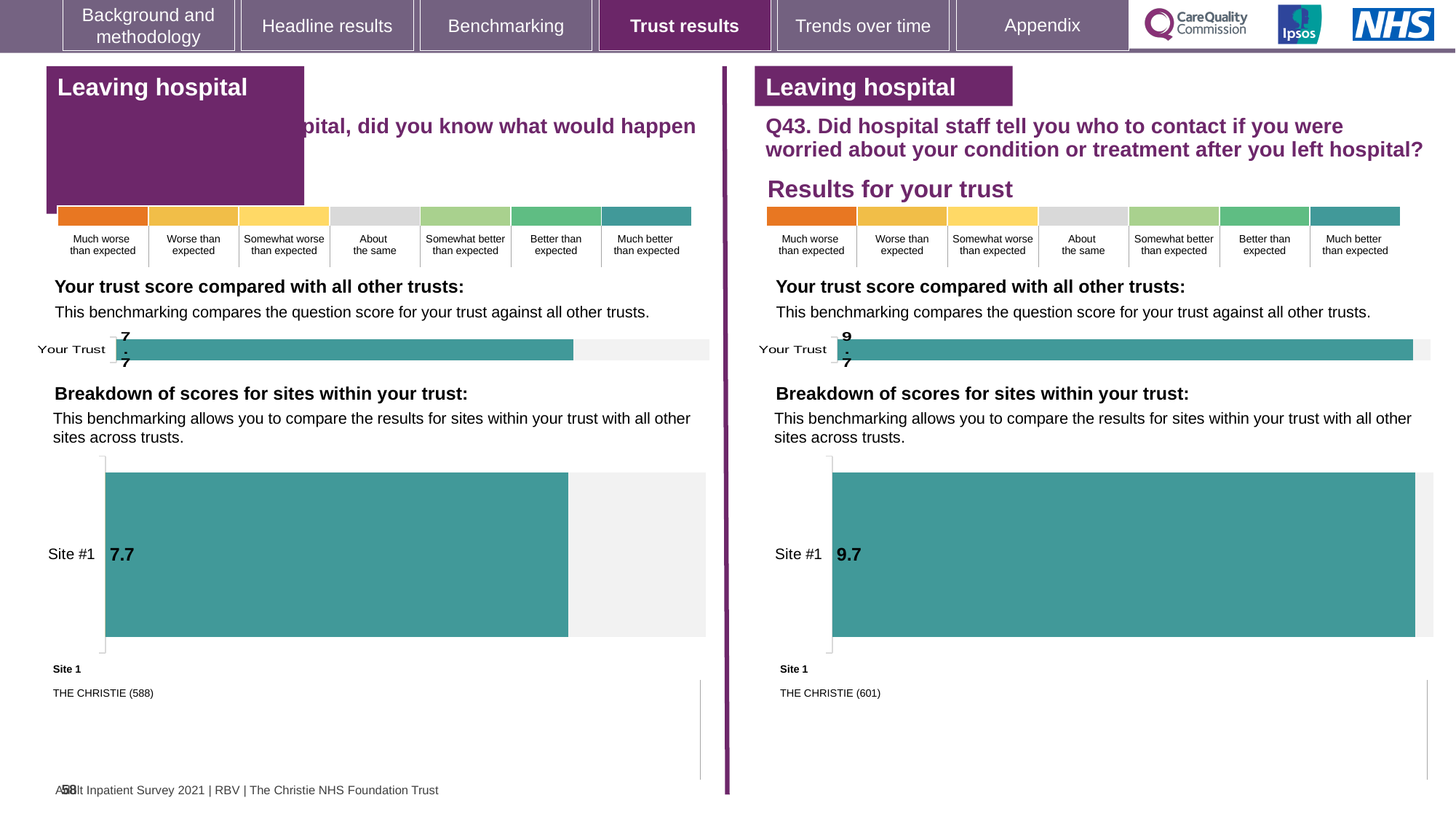
In the left 'Breakdown of scores for sites within your trust' chart, what is the score for Site #1? 7.7 What kind of chart is used to show the Your Trust score on the left half of the slide? Bar chart What is the difference between the Site #1 score in the right (Q43) breakdown chart and the Site #1 score in the left breakdown chart? 2.0 Which is larger: the Site #1 score in the left breakdown chart or the Site #1 score in the right (Q43) breakdown chart? The right (Q43) chart, 9.7 How many sites are shown in the right (Q43) 'Breakdown of scores for sites within your trust' chart? 1 On the right half of the slide (Q43), what is the score shown for Your Trust in the 'Your trust score compared with all other trusts' chart? 9.7 What kind of chart is used for the Site #1 breakdown on the right half of the slide? Bar chart How many sites are shown in the left 'Breakdown of scores for sites within your trust' chart? 1 In the right 'Breakdown of scores for sites within your trust' chart for Q43, what is the score for Site #1? 9.7 On the left half of the slide, what is the score shown for Your Trust in the 'Your trust score compared with all other trusts' chart? 7.7 Which site name is listed as Site 1 beneath the left breakdown chart? THE CHRISTIE (588) Which site name is listed as Site 1 beneath the right (Q43) breakdown chart? THE CHRISTIE (601)